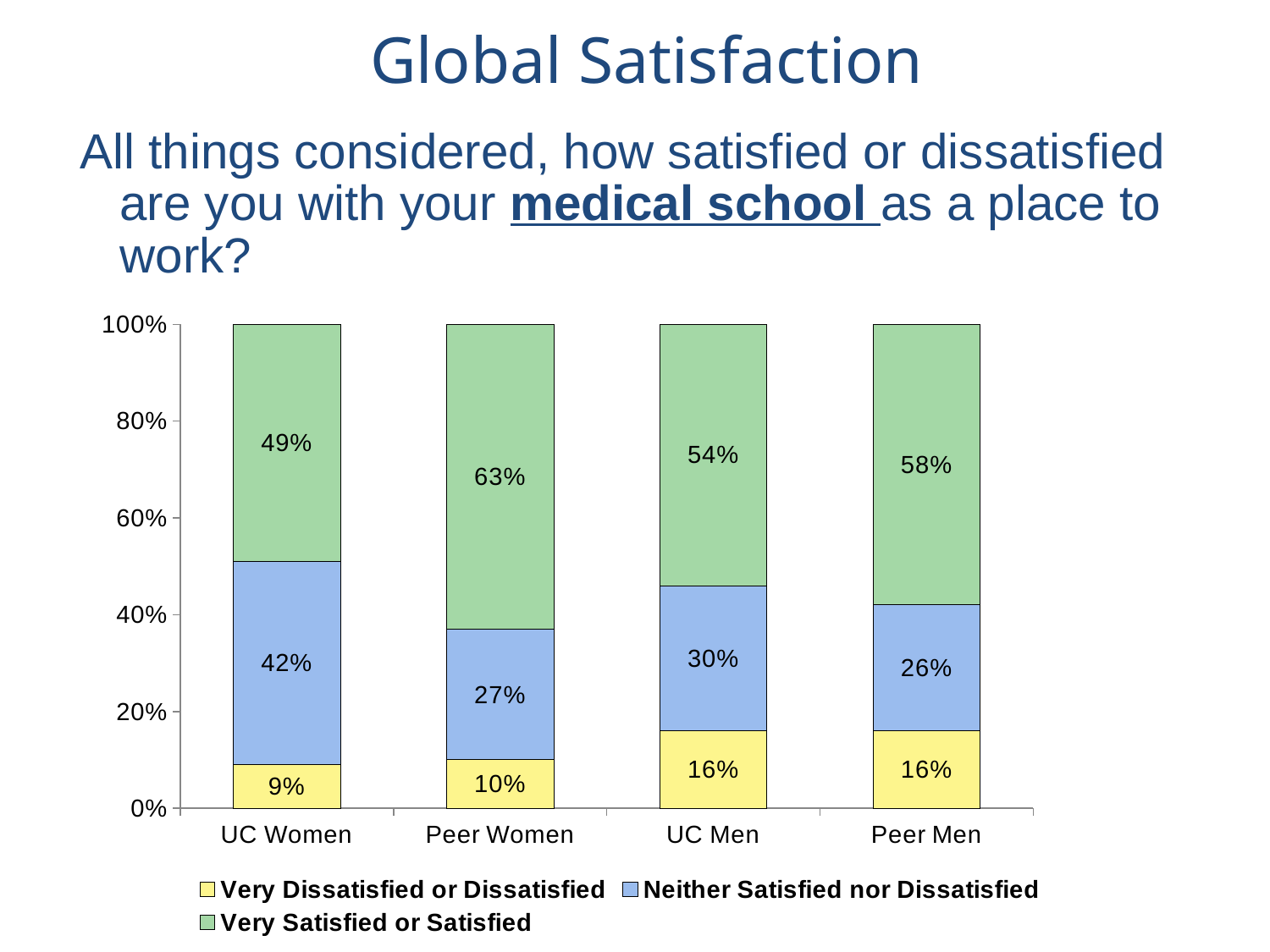
Which is larger, the Neither Satisfied nor Dissatisfied share for UC Women or for UC Men? UC Women Which group has the lowest share of Very Dissatisfied or Dissatisfied? UC Women What percentage of UC Men are Very Dissatisfied or Dissatisfied? 16% What percentage of Peer Men are Neither Satisfied nor Dissatisfied? 26% What kind of chart is shown on the slide? Stacked bar chart What is the total of the UC Men bar? 100% What percentage of UC Women are Very Satisfied or Satisfied? 49% What is the difference between the Very Satisfied or Satisfied share for Peer Women and UC Women? 14% Which group has the highest share of Very Satisfied or Satisfied? Peer Women How many series does the legend list? 3 Which colour represents Very Satisfied or Satisfied in the legend? Green How many groups are shown on the x axis? 4